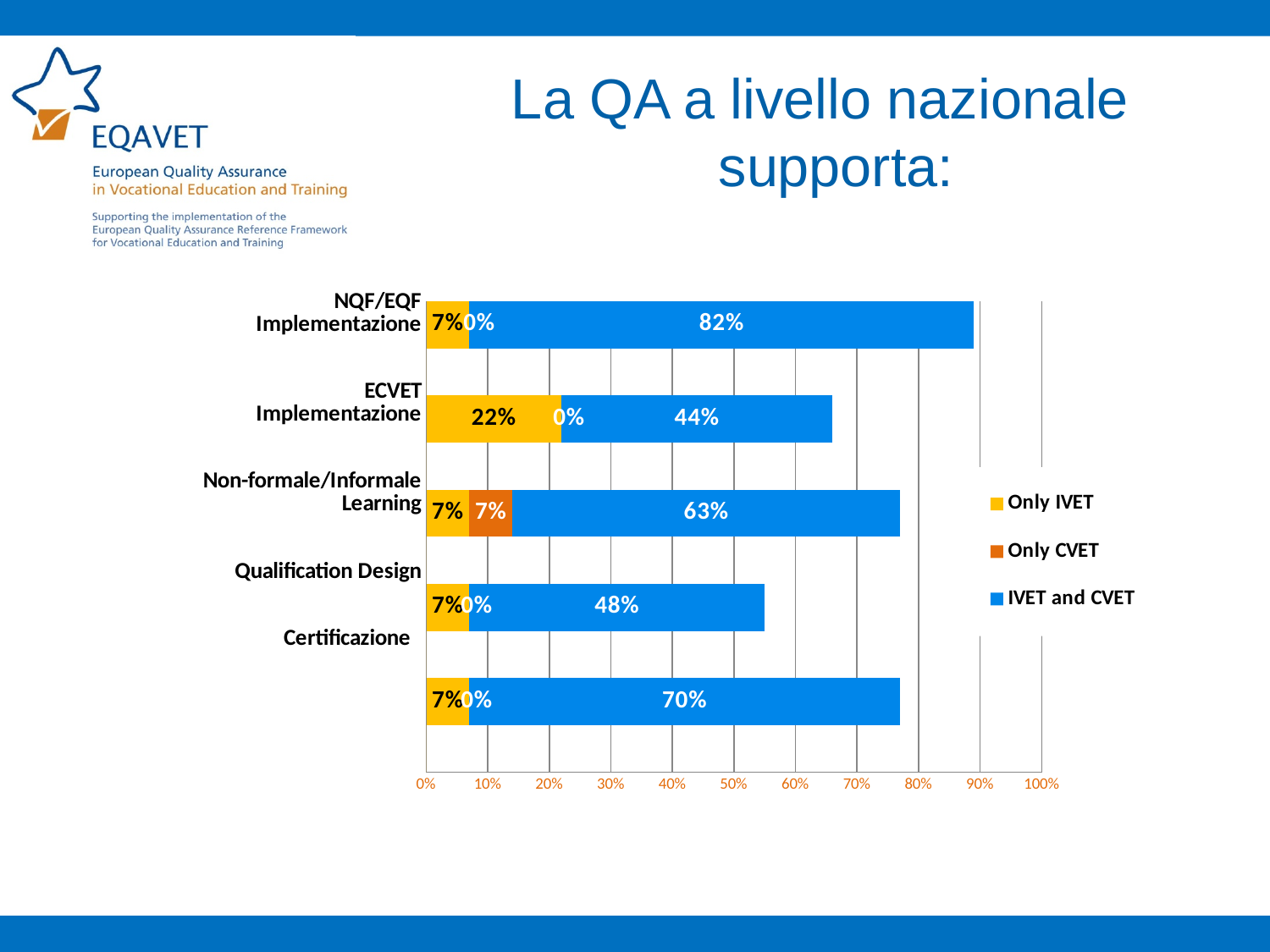
Which category has the lowest IVET and CVET value? ECVET Implementazione What is the total of the stacked bar for Non-formale/Informale Learning? 77% What is the IVET and CVET value for NQF/EQF Implementazione? 82% What is the IVET and CVET value for Certificazione? 70% How many series does the legend list? 3 How many categories are plotted in the chart? 5 Which series is shown in orange in the legend? Only CVET What type of chart is shown on the slide? Stacked bar chart What is the Only IVET value for ECVET Implementazione? 22% Which category has the highest IVET and CVET value? NQF/EQF Implementazione What is the Only CVET value for Non-formale/Informale Learning? 7% What is the difference between the IVET and CVET values for NQF/EQF Implementazione and Qualification Design? 34%